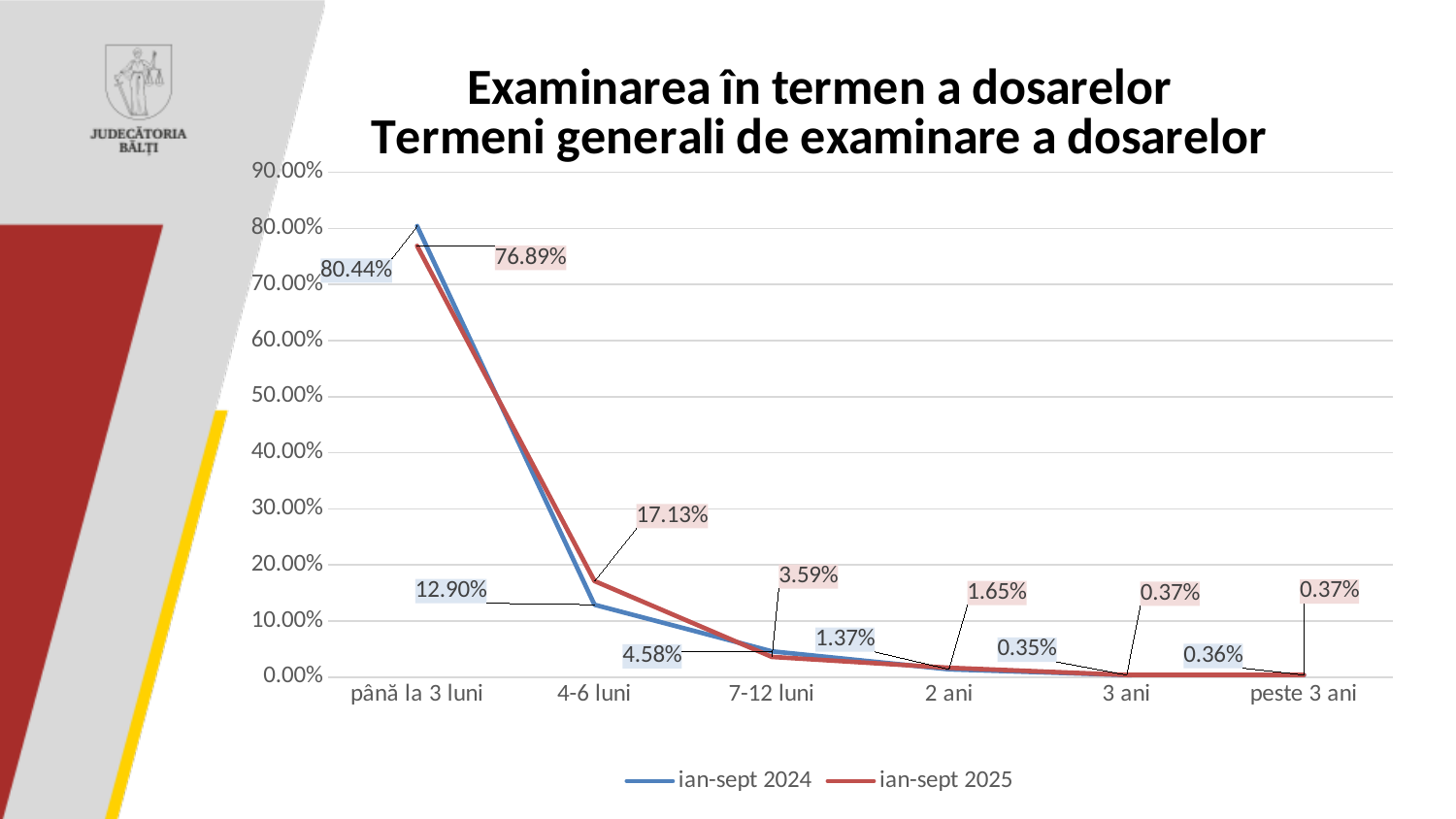
For '2 ani', which series has the larger value, ian-sept 2024 or ian-sept 2025? ian-sept 2025 What is the difference between the ian-sept 2024 and ian-sept 2025 values for '4-6 luni'? 4.23% What type of chart is shown on the slide? line chart How many categories are shown on the x axis? 6 Which category has the highest value in the ian-sept 2024 series? până la 3 luni What is the value for 'până la 3 luni' in the ian-sept 2024 series? 80.44% Which category has the lowest value in the ian-sept 2024 series? 3 ani What is the value for '7-12 luni' in the ian-sept 2024 series? 4.58% What is the value for 'până la 3 luni' in the ian-sept 2025 series? 76.89% Do the values in the ian-sept 2025 series rise or fall from 'până la 3 luni' to '3 ani'? fall How many series does the legend list? 2 What is the value for '4-6 luni' in the ian-sept 2025 series? 17.13%